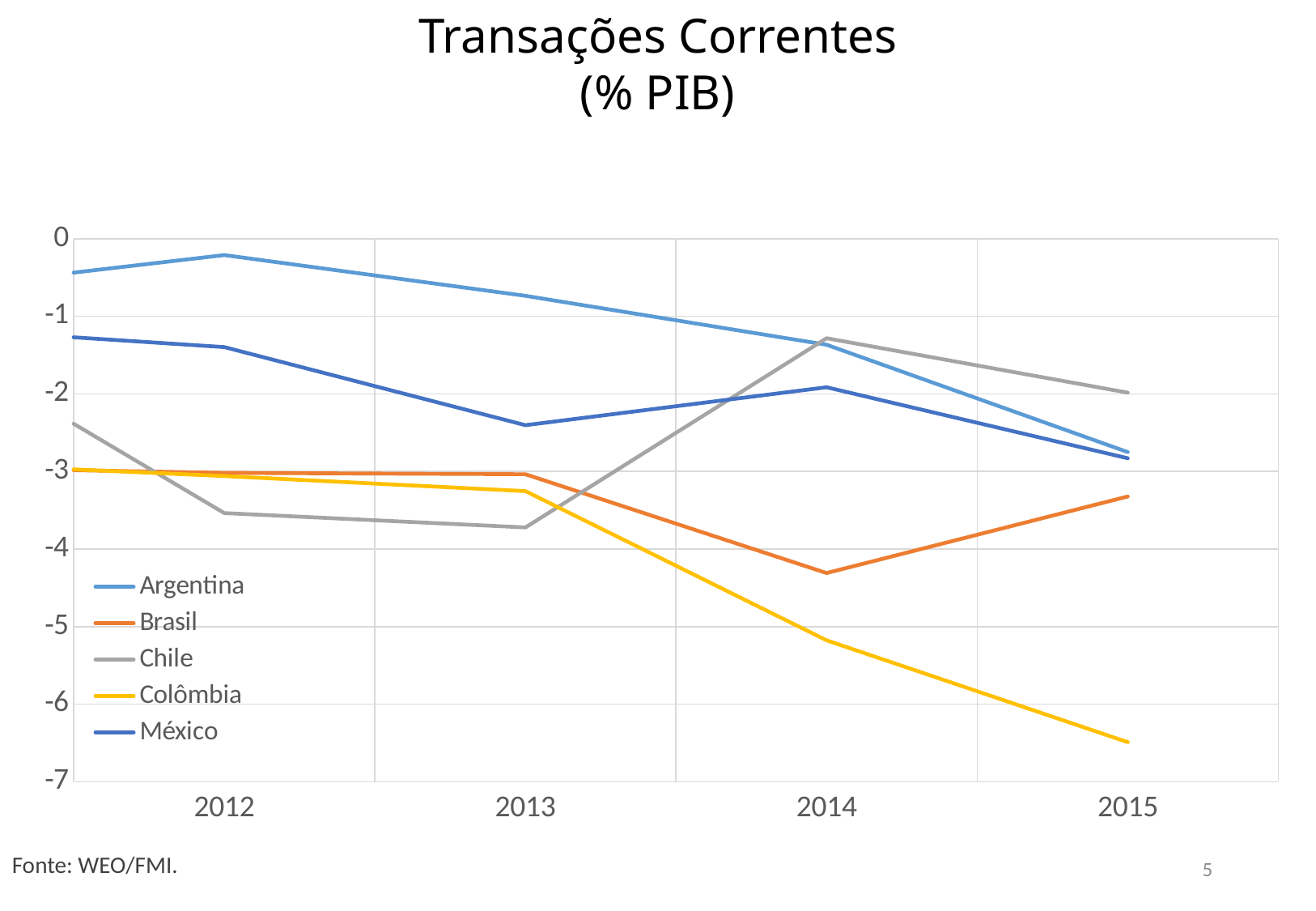
Is the value for Chile in 2014 greater or less than -2? greater What kind of chart is shown on the slide? line chart Does the Colômbia line rise or fall from 2012 to 2015? fall Which country has the highest value in 2015? Chile Which country has the lowest value in 2015? Colômbia Which country has the highest value in 2012? Argentina Is the value for Brasil in 2014 greater or less than -4? less In 2014, which is higher: Chile or Brasil? Chile Is the value for Colômbia in 2015 greater or less than -6? less How many years are labelled on the x axis? 4 How many series does the legend list? 5 Which country has the lowest value in 2014? Colômbia